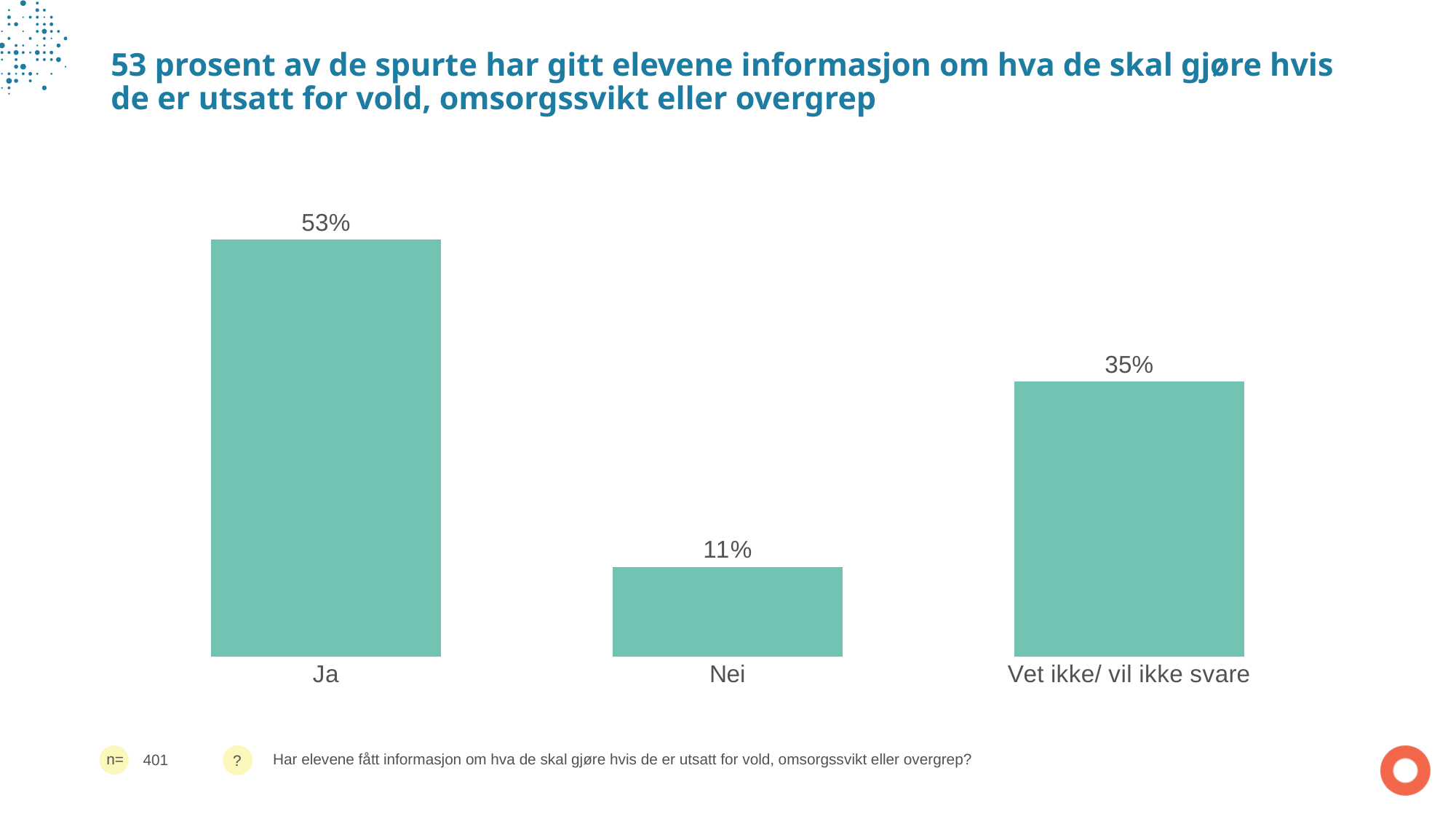
What colour are the bars in the chart? Teal (green-blue) Which category has the highest value? Ja What kind of chart is shown on the slide? Bar chart What is the difference between the values for "Ja" and "Vet ikke/ vil ikke svare"? 18% What is the value for "Nei"? 11% What is the value for "Vet ikke/ vil ikke svare"? 35% What is the difference between the values for "Ja" and "Nei"? 42% How many categories are shown in the chart? 3 What is the value for "Ja"? 53% Which is larger, the value for "Nei" or the value for "Vet ikke/ vil ikke svare"? Vet ikke/ vil ikke svare Which category has the lowest value? Nei What is the sample size (n) shown on the slide? 401